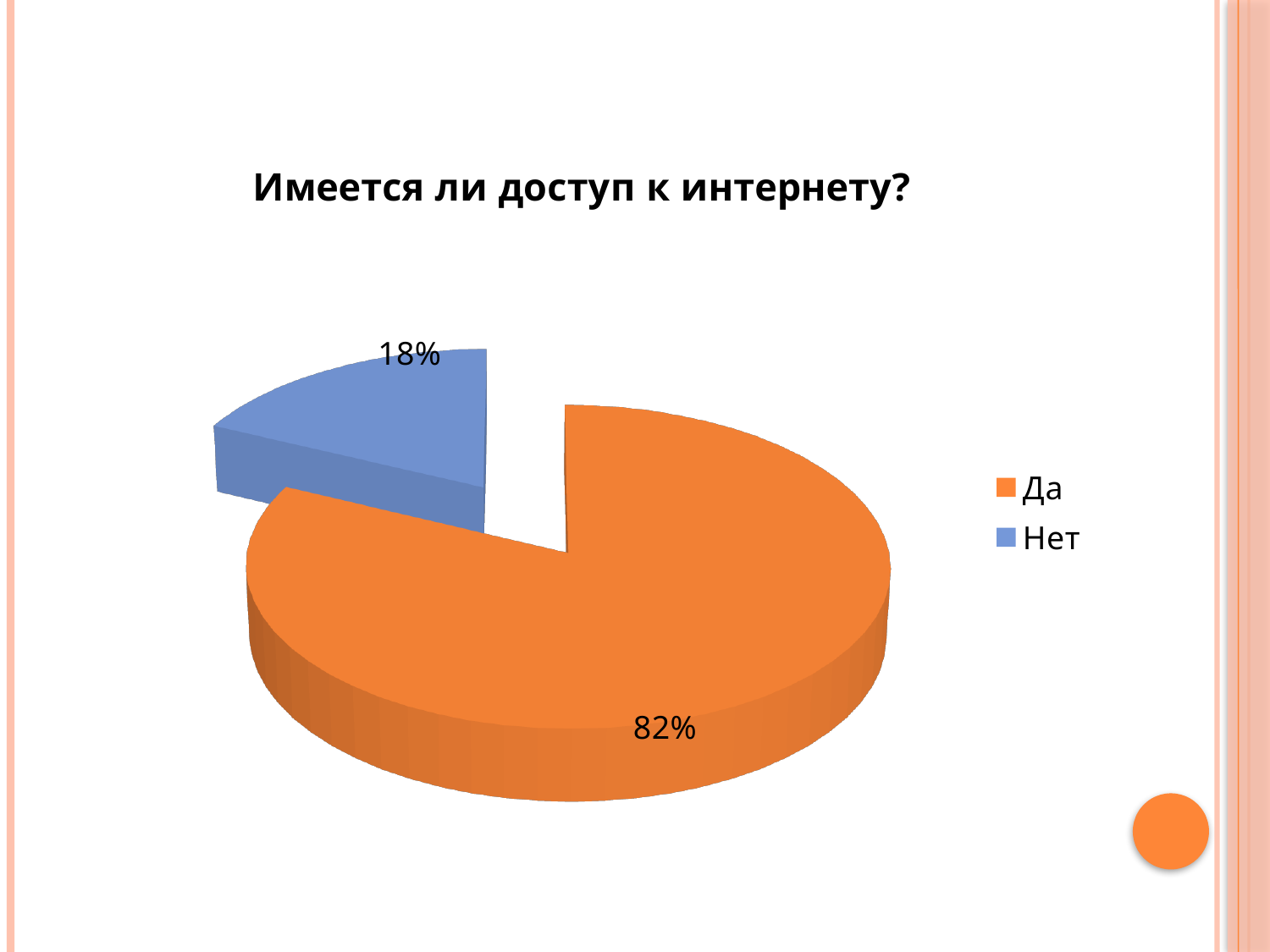
What kind of chart is shown on the slide? pie chart Which category has the smallest slice? Нет How many slices does the pie chart have? 2 What is the difference in percentage points between "Да" and "Нет"? 64 What colour is the slice for "Нет"? blue Which is larger, the share for "Да" or the share for "Нет"? Да What share of the pie does "Да" take? 82% Which category has the largest slice? Да How many entries does the legend list? 2 What share of the pie does "Нет" take? 18% What is the title of the chart? Имеется ли доступ к интернету?